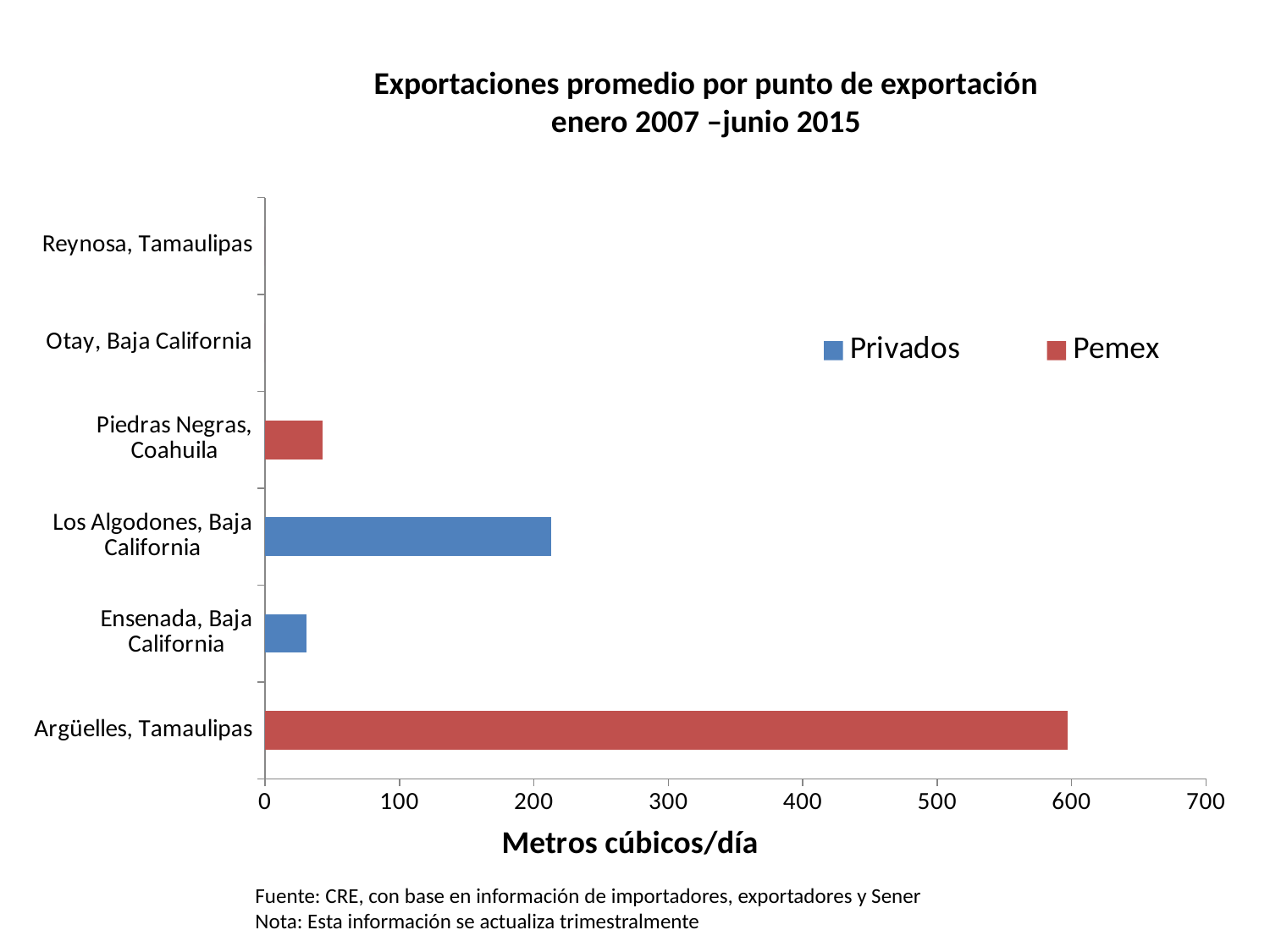
Is the value for Piedras Negras, Coahuila greater or less than 100? less Which is larger, the value for Argüelles, Tamaulipas or the value for Los Algodones, Baja California? Argüelles, Tamaulipas How many series does the legend list? 2 What unit is shown on the horizontal axis label? Metros cúbicos/día Which series does the bar for Argüelles, Tamaulipas belong to? Pemex Which is larger, the value for Los Algodones, Baja California or the value for Ensenada, Baja California? Los Algodones, Baja California What kind of chart is shown on the slide? Bar chart Is the value for Ensenada, Baja California greater or less than 100? less How many export points (categories) are listed on the vertical axis? 6 Which export point has the highest average exports? Argüelles, Tamaulipas Is the value for Argüelles, Tamaulipas greater or less than 500? greater